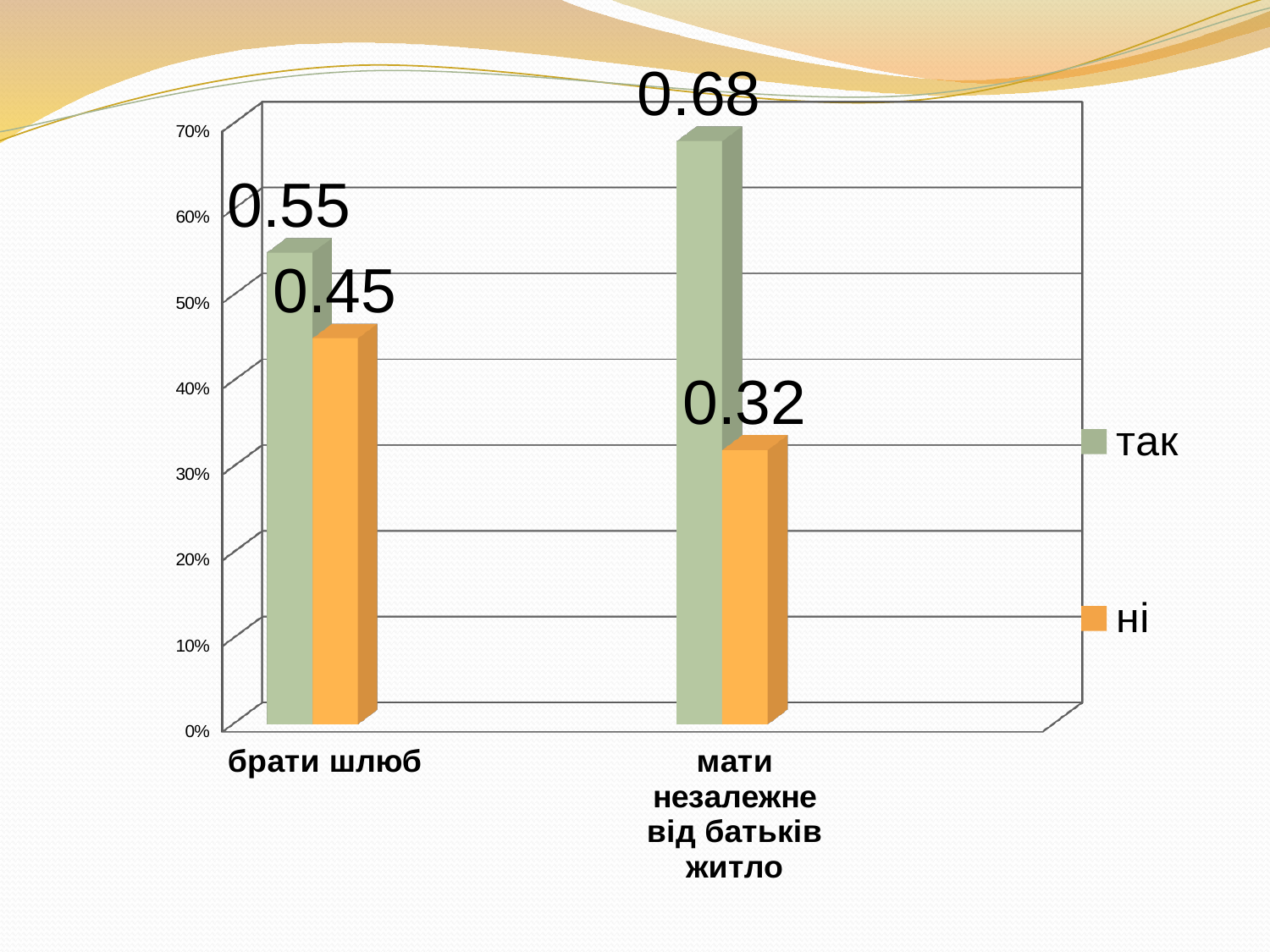
Which category has the lowest value for the "ні" series? мати незалежне від батьків житло What is the value for "ні" in the "брати шлюб" category? 0.45 Which is larger: the "так" value for "брати шлюб" or the "так" value for "мати незалежне від батьків житло"? мати незалежне від батьків житло What is the difference between the "так" and "ні" values in the "брати шлюб" category? 0.10 Which category has the highest value for the "так" series? мати незалежне від батьків житло What is the value for "так" in the "брати шлюб" category? 0.55 What is the value for "так" in the "мати незалежне від батьків житло" category? 0.68 What is the value for "ні" in the "мати незалежне від батьків житло" category? 0.32 What kind of chart is shown on the slide? bar chart How many categories are shown on the x axis? 2 How many series does the legend list? 2 What is the difference between the "так" and "ні" values in the "мати незалежне від батьків житло" category? 0.36